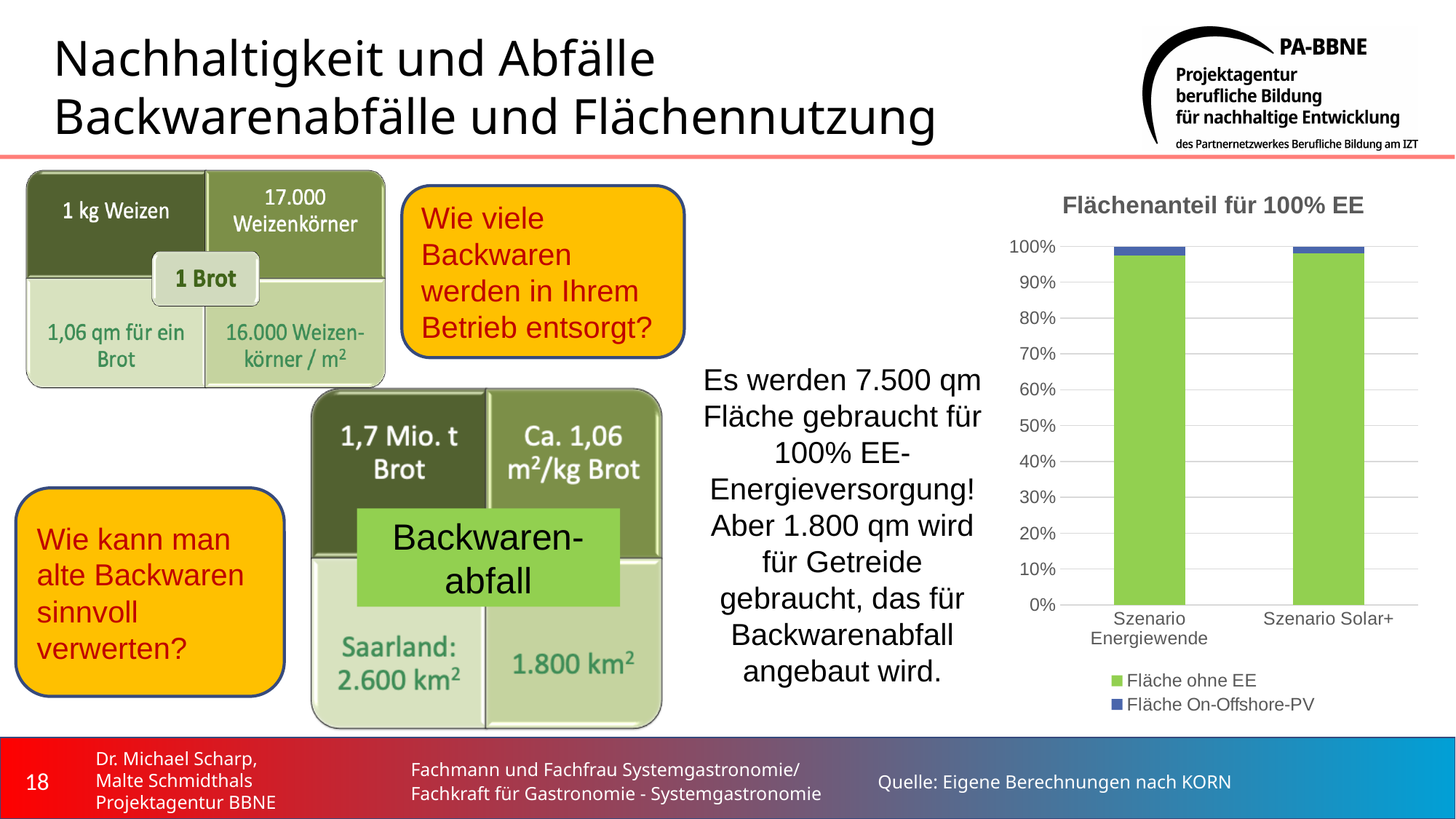
Is the value of Fläche On-Offshore-PV for Szenario Solar+ greater or less than 10%? less Is the value of Fläche ohne EE for Szenario Energiewende greater or less than 90%? greater Is the value of Fläche ohne EE for Szenario Solar+ greater or less than 90%? greater What is the title of the chart? Flächenanteil für 100% EE Which series is shown in green in the chart? Fläche ohne EE What is the label of the second category on the x axis? Szenario Solar+ How many categories are shown on the x axis of the chart? 2 What kind of chart is shown on the slide? stacked bar chart What is the total height of the stacked bar for Szenario Energiewende? 100% How many series does the chart's legend list? 2 What is the total height of the stacked bar for Szenario Solar+? 100%